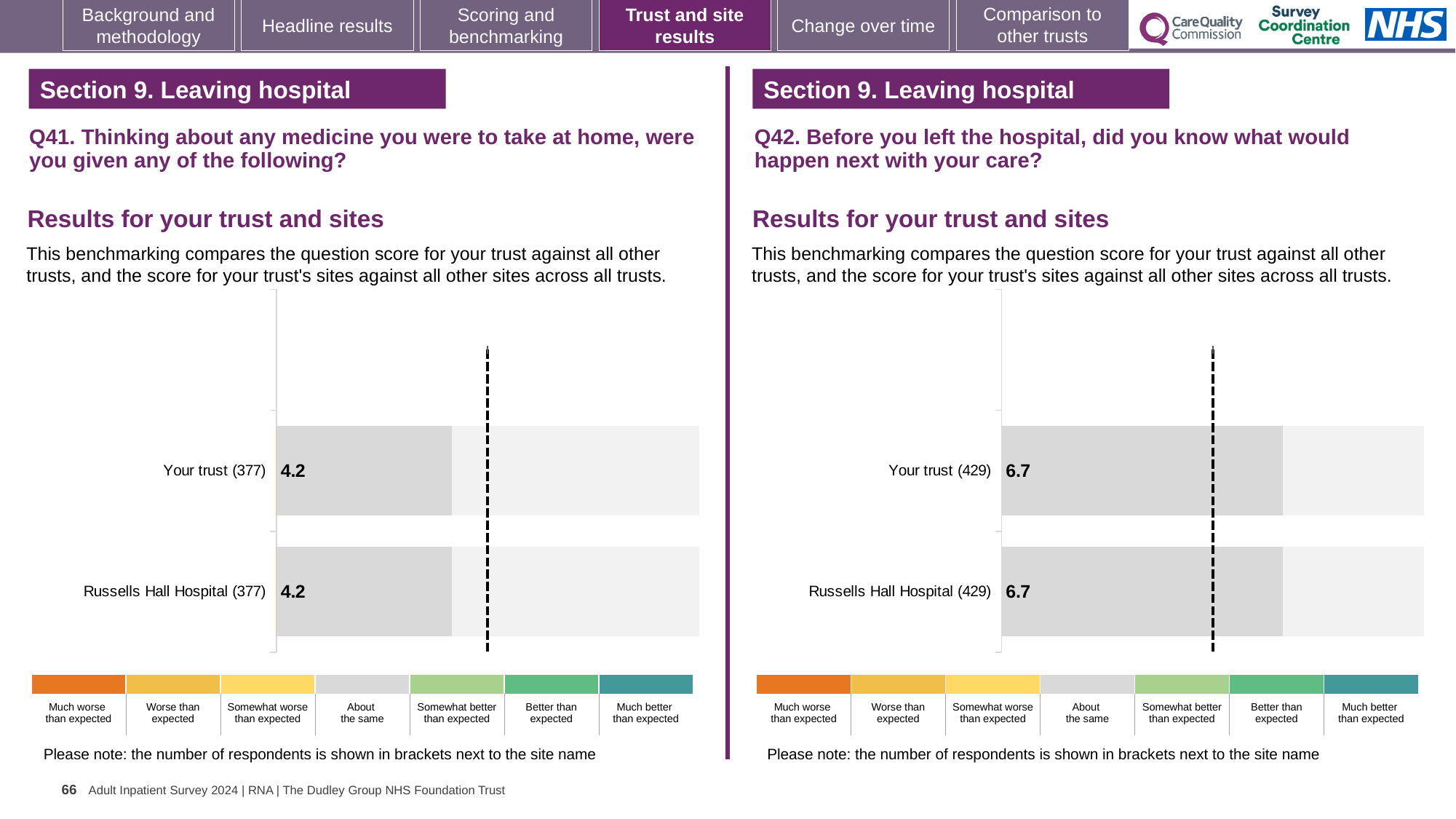
On the Q42 chart on the right, how many respondents are shown in brackets next to Your trust? 429 How many categories does the colour key below each chart list, from 'Much worse than expected' to 'Much better than expected'? 7 On the Q41 chart on the left, how many bars are plotted? 2 On the Q41 chart on the left, what is the score for Russells Hall Hospital? 4.2 On the Q41 chart on the left, what is the score for Your trust? 4.2 On the Q41 chart on the left, how many respondents are shown in brackets next to Russells Hall Hospital? 377 On the Q42 chart on the right, what is the score for Russells Hall Hospital? 6.7 Is the Your trust score on the Q42 chart on the right larger than the Your trust score on the Q41 chart on the left? Yes On the Q41 chart on the left, what is the difference between the score for Your trust and the score for Russells Hall Hospital? 0 On the Q42 chart on the right, what is the score for Your trust? 6.7 On the Q42 chart on the right, how many bars are plotted? 2 What kind of chart is the Q41 chart on the left? Bar chart